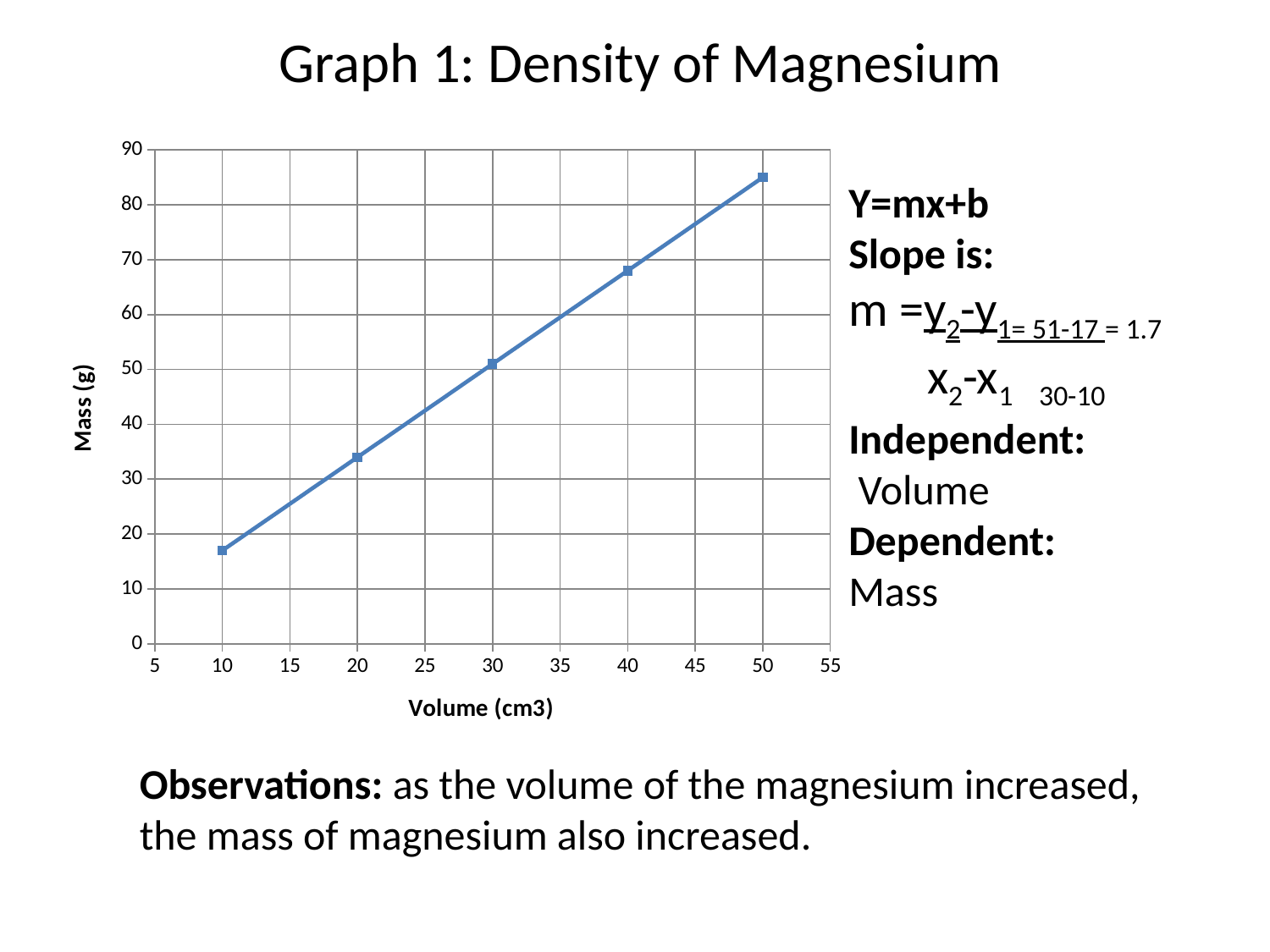
Which has the larger mass: the point at volume 30 or the point at volume 20? volume 30 Is the mass at a volume of 40 greater or less than 60? greater Does the mass rise or fall as the volume increases along the x axis? rise How many data points are plotted on the chart? 5 What kind of chart is shown on the slide? line chart Is the mass at a volume of 20 greater or less than 40? less What is the label on the y axis of the chart? Mass (g) Is the mass at a volume of 50 greater or less than 80? greater At which volume is the plotted mass lowest? 10 What is the title of the chart? Graph 1: Density of Magnesium At which volume is the plotted mass highest? 50